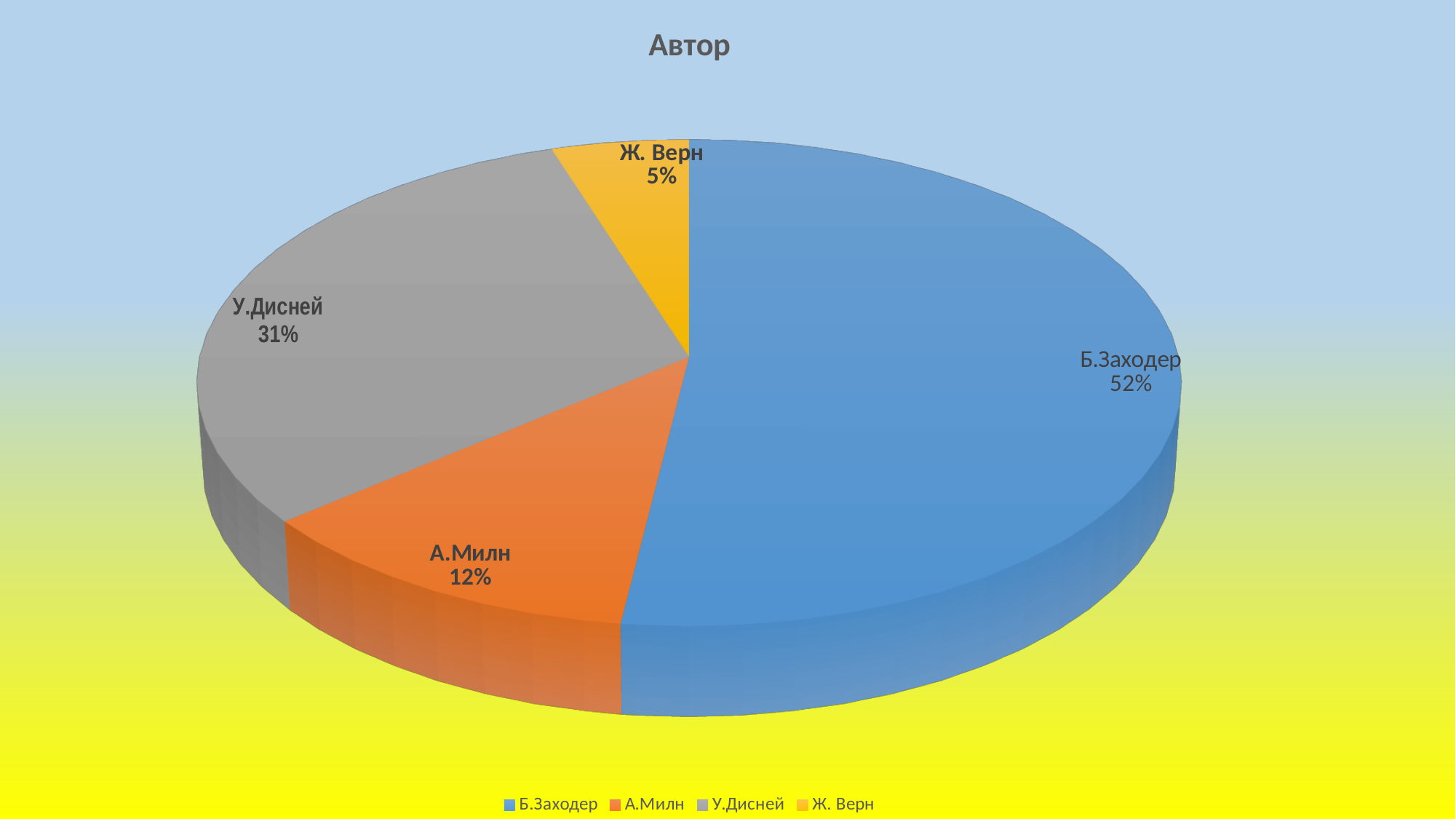
Which author has the largest slice of the pie? Б.Заходер Which is larger, the share for А.Милн or the share for Ж. Верн? А.Милн What share of the pie does У.Дисней have? 31% What is the title of the chart? Автор What share of the pie does А.Милн have? 12% What share of the pie does Ж. Верн have? 5% How many slices does the pie chart have? 4 What is the difference in percentage points between Б.Заходер and У.Дисней? 21 What colour is the slice for У.Дисней? grey Which author has the smallest slice of the pie? Ж. Верн What type of chart is shown on the slide? pie chart